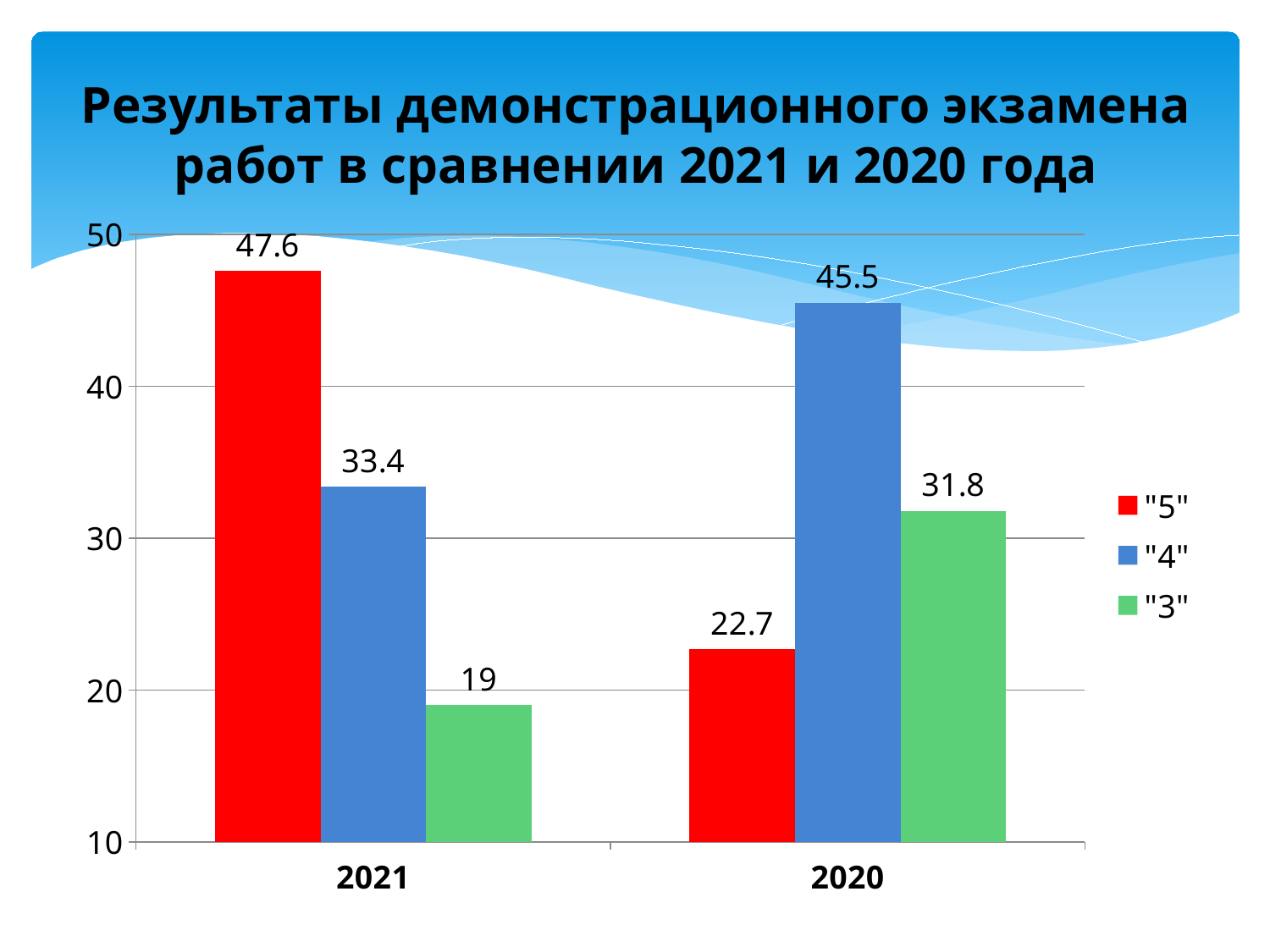
What is the value for "5" in 2021? 47.6 What is the value for "4" in 2020? 45.5 What colour represents the "4" series? Blue How many categories are shown on the x axis? 2 What is the value for "5" in 2020? 22.7 How many series does the legend list? 3 Which series has the lowest value in 2020? "5" What kind of chart is shown on the slide? Bar chart Which is larger: the "3" value in 2021 or in 2020? 2020 Which series has the highest value in 2021? "5" What is the difference between the "5" values for 2021 and 2020? 24.9 What is the value for "3" in 2021? 19